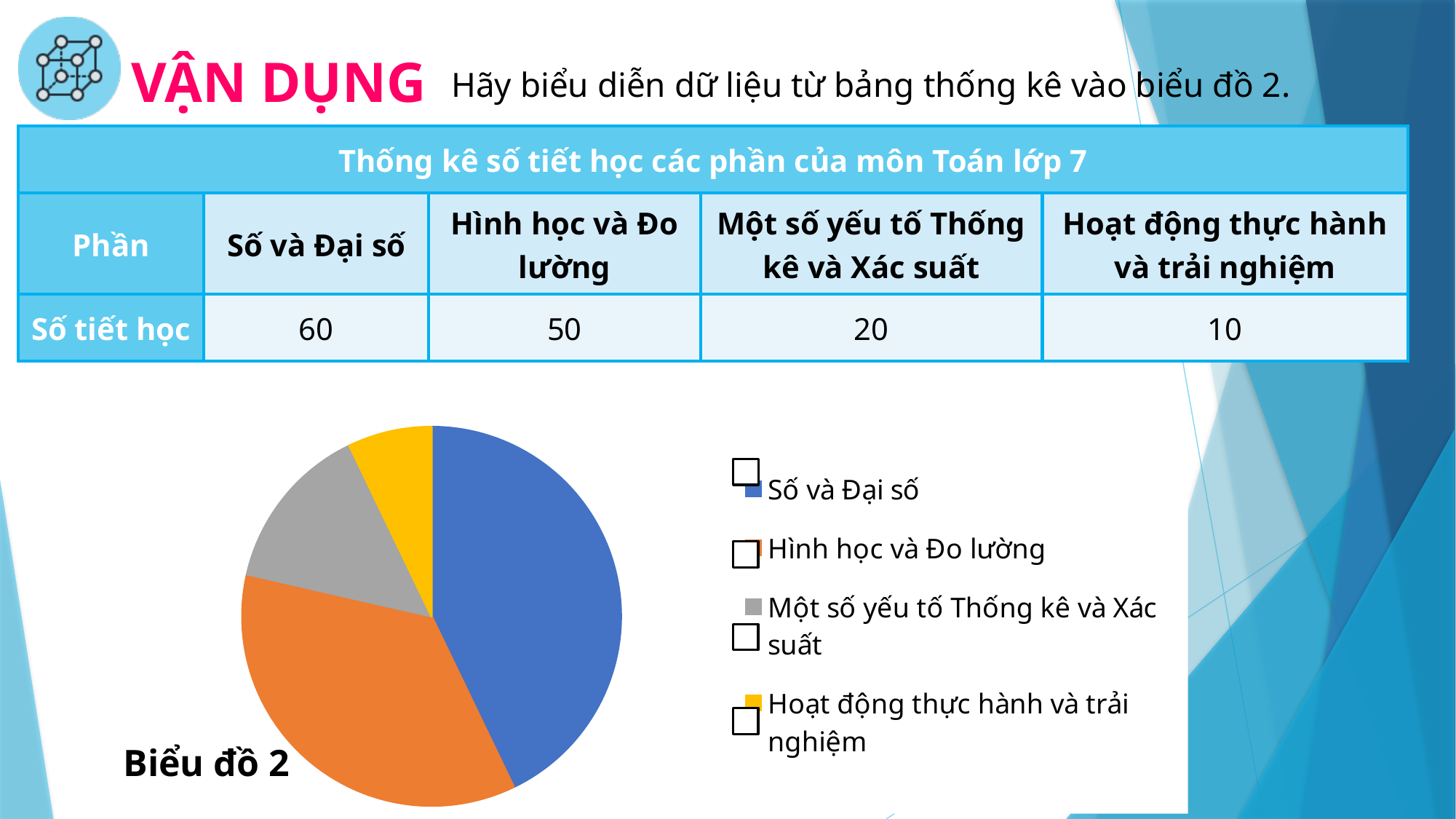
According to the table, how many lessons (số tiết học) does Số và Đại số have? 60 How many slices does the pie chart Biểu đồ 2 have? 4 What kind of chart is Biểu đồ 2? pie chart How many entries does the legend of Biểu đồ 2 list? 4 In Biểu đồ 2, which slice is larger: Số và Đại số or Hình học và Đo lường? Số và Đại số Using the table values, what is the total number of lessons across all four parts shown in Biểu đồ 2? 140 Which category has the largest slice in Biểu đồ 2? Số và Đại số What colour is the Số và Đại số slice in Biểu đồ 2? blue In Biểu đồ 2, which slice is larger: Một số yếu tố Thống kê và Xác suất or Hoạt động thực hành và trải nghiệm? Một số yếu tố Thống kê và Xác suất Which category has the smallest slice in Biểu đồ 2? Hoạt động thực hành và trải nghiệm According to the table, how many lessons (số tiết học) does Một số yếu tố Thống kê và Xác suất have? 20 Using the table values, what is the difference in lessons between Số và Đại số and Hình học và Đo lường? 10